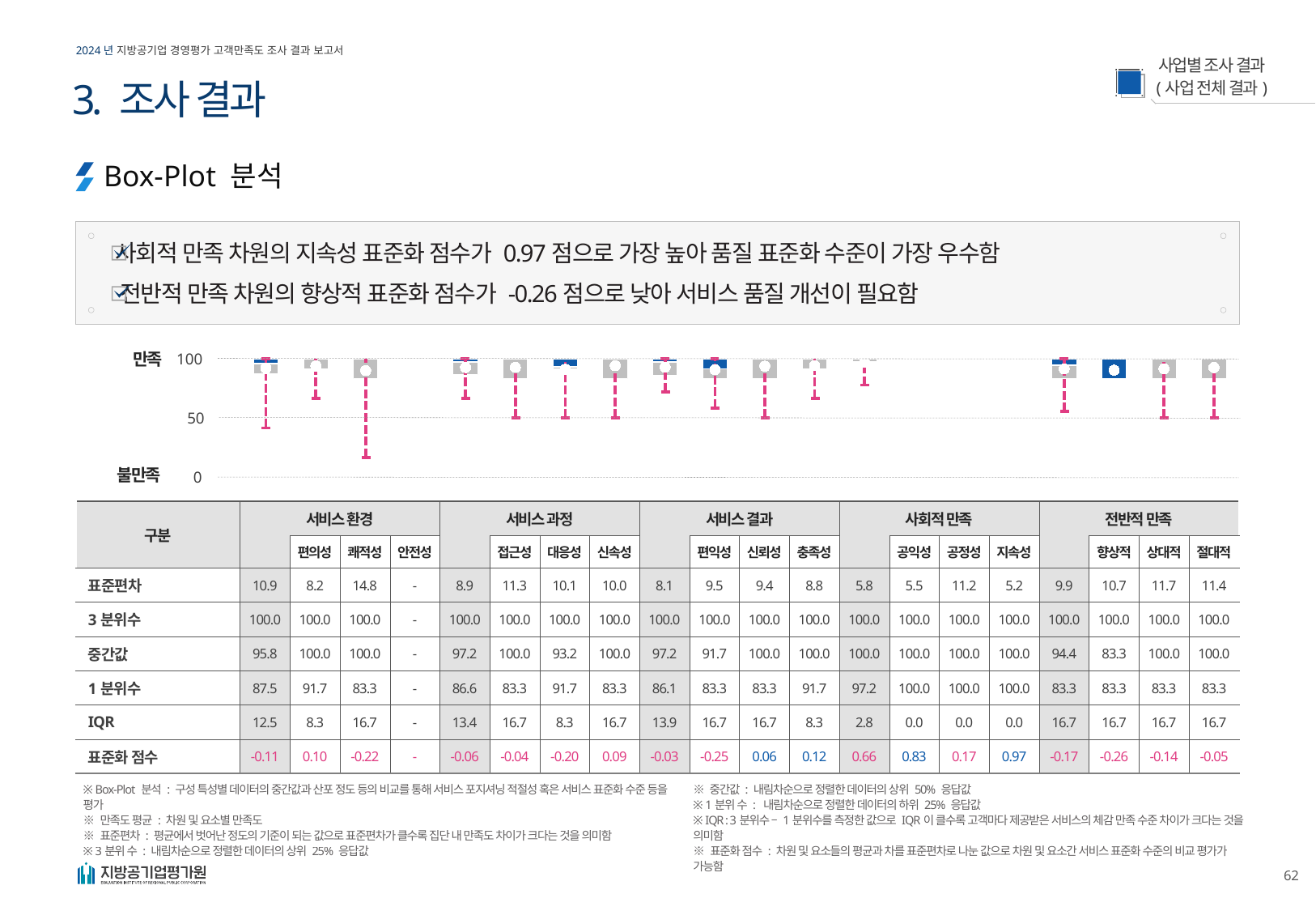
What label is shown next to the 0 tick on the vertical axis of the box plot chart? 불만족 Which item has the lowest 표준화 점수 in the table? 향상적 What is the 표준화 점수 for 향상적 under 전반적 만족? -0.26 Which has the larger 중간값 under 전반적 만족: 향상적 or 상대적? 상대적 What kind of chart is shown on the slide? Box plot What is the highest tick value shown on the vertical axis of the box plot chart? 100 What is the IQR for 공익성 under 사회적 만족? 0.0 How many dimension groups (e.g., 서비스 환경, 서비스 과정) are listed in the table header? 5 What is the 표준화 점수 for 지속성 under 사회적 만족? 0.97 Which item has the highest 표준화 점수 in the table? 지속성 What is the 표준편차 for 쾌적성 under 서비스 환경? 14.8